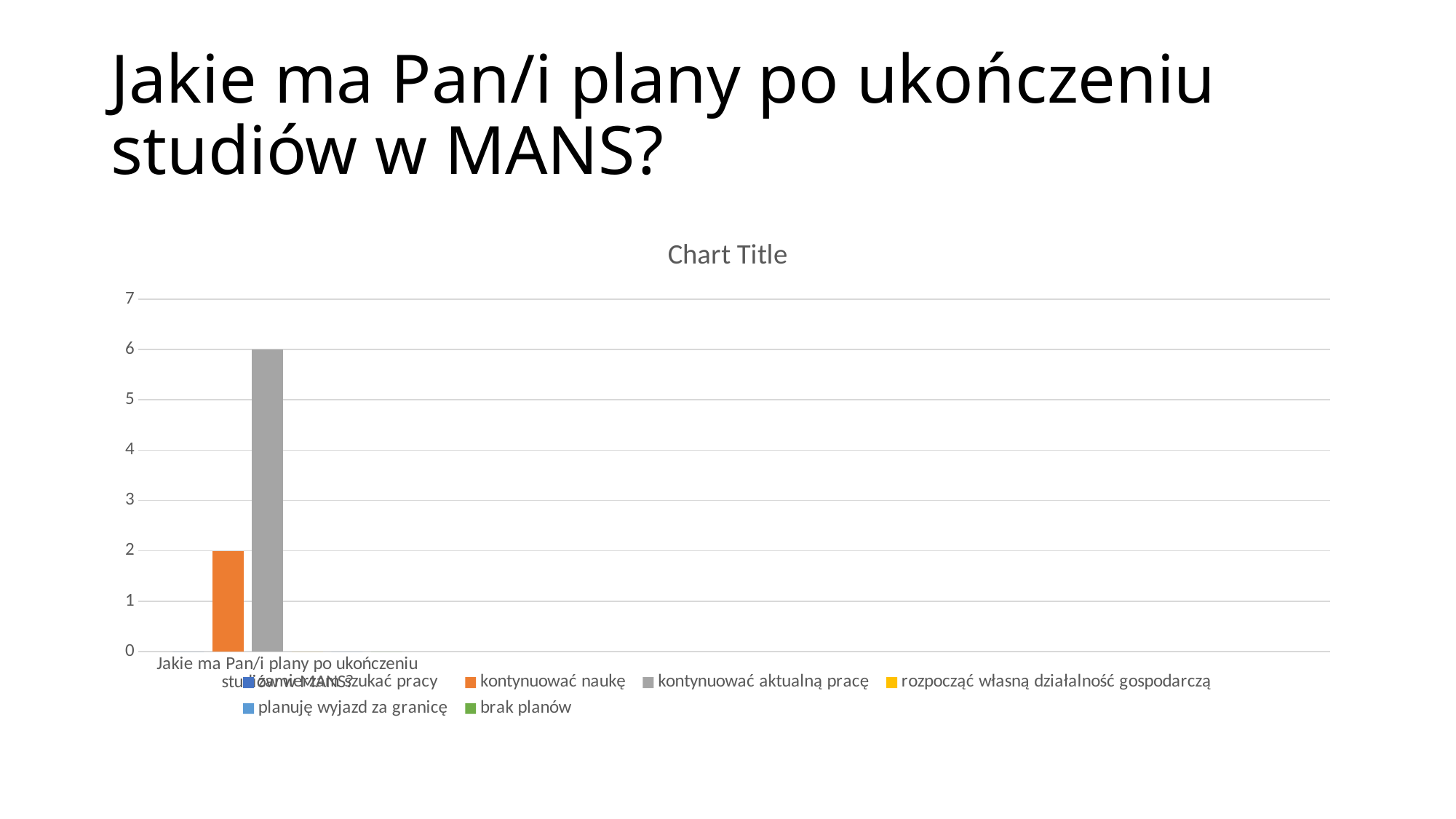
What is the title shown above the chart? Chart Title What is the value for the series "kontynuować naukę"? 2 What is the value for the series "kontynuować aktualną pracę"? 6 How many series does the legend list? 6 Which series has the highest value in the chart? kontynuować aktualną pracę Is the value for "kontynuować naukę" greater or less than 3? less Which is larger: the value for "kontynuować naukę" or the value for "kontynuować aktualną pracę"? kontynuować aktualną pracę What colour is the bar for "kontynuować aktualną pracę"? gray How many categories are shown on the x axis? 1 What is the difference between the values for "kontynuować aktualną pracę" and "kontynuować naukę"? 4 Is the value for "kontynuować aktualną pracę" greater or less than 5? greater What kind of chart is shown on the slide? bar chart